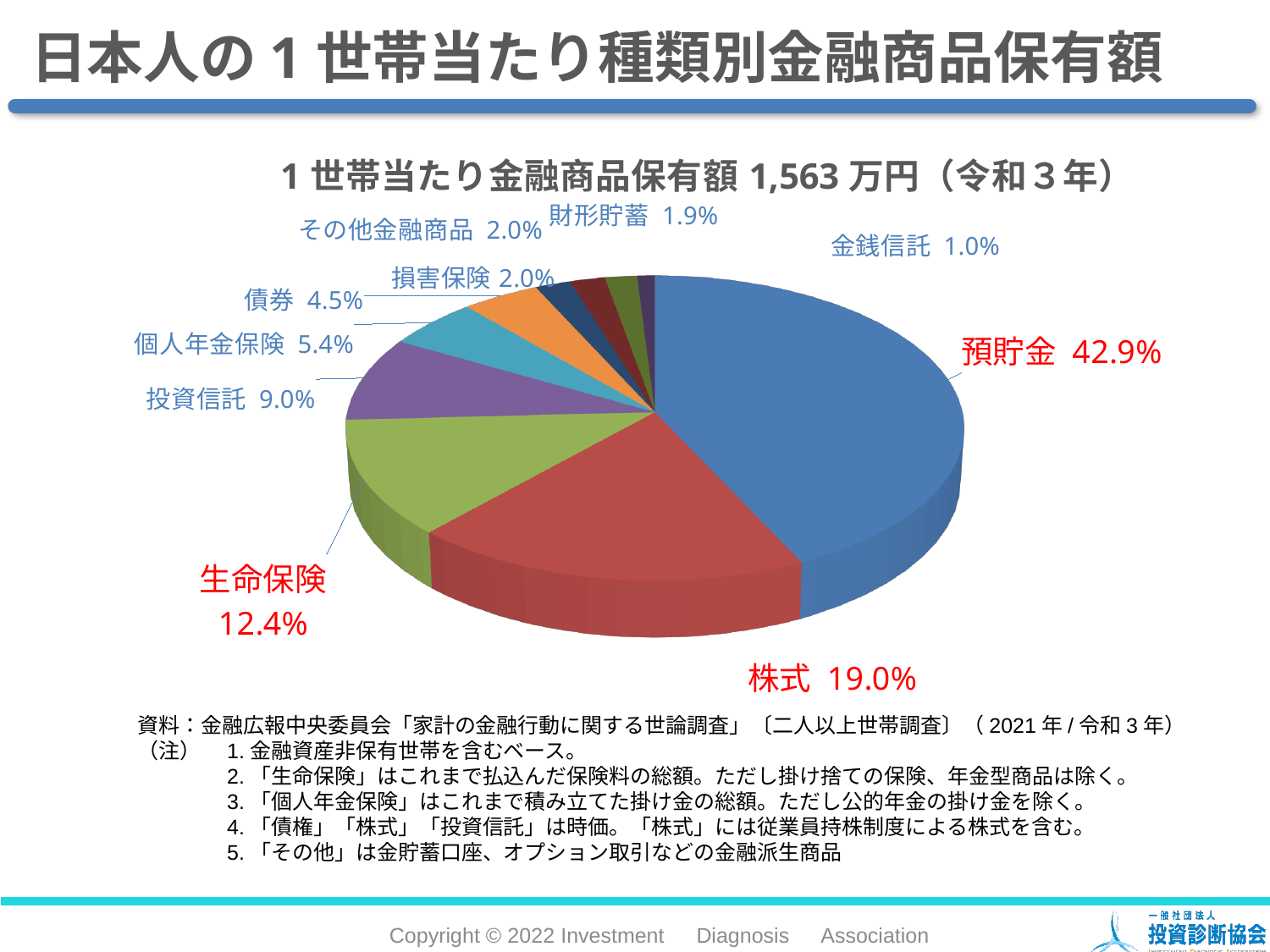
What is the value labelled for 生命保険? 12.4% What total amount per household is stated in the chart title? 1,563 万円 Which category has the smallest slice of the pie? 金銭信託 What is the difference in percentage points between 預貯金 and 株式? 23.9 Which is larger, 個人年金保険 or 債券? 個人年金保険 What kind of chart is shown on the slide? Pie chart What percentage is shown for 株式? 19.0% What is the difference in percentage points between 生命保険 and 投資信託? 3.4 What share of the pie does 預貯金 hold? 42.9% What percentage is shown for 投資信託? 9.0% Which category has the largest slice of the pie? 預貯金 How many categories are shown in the pie chart? 10